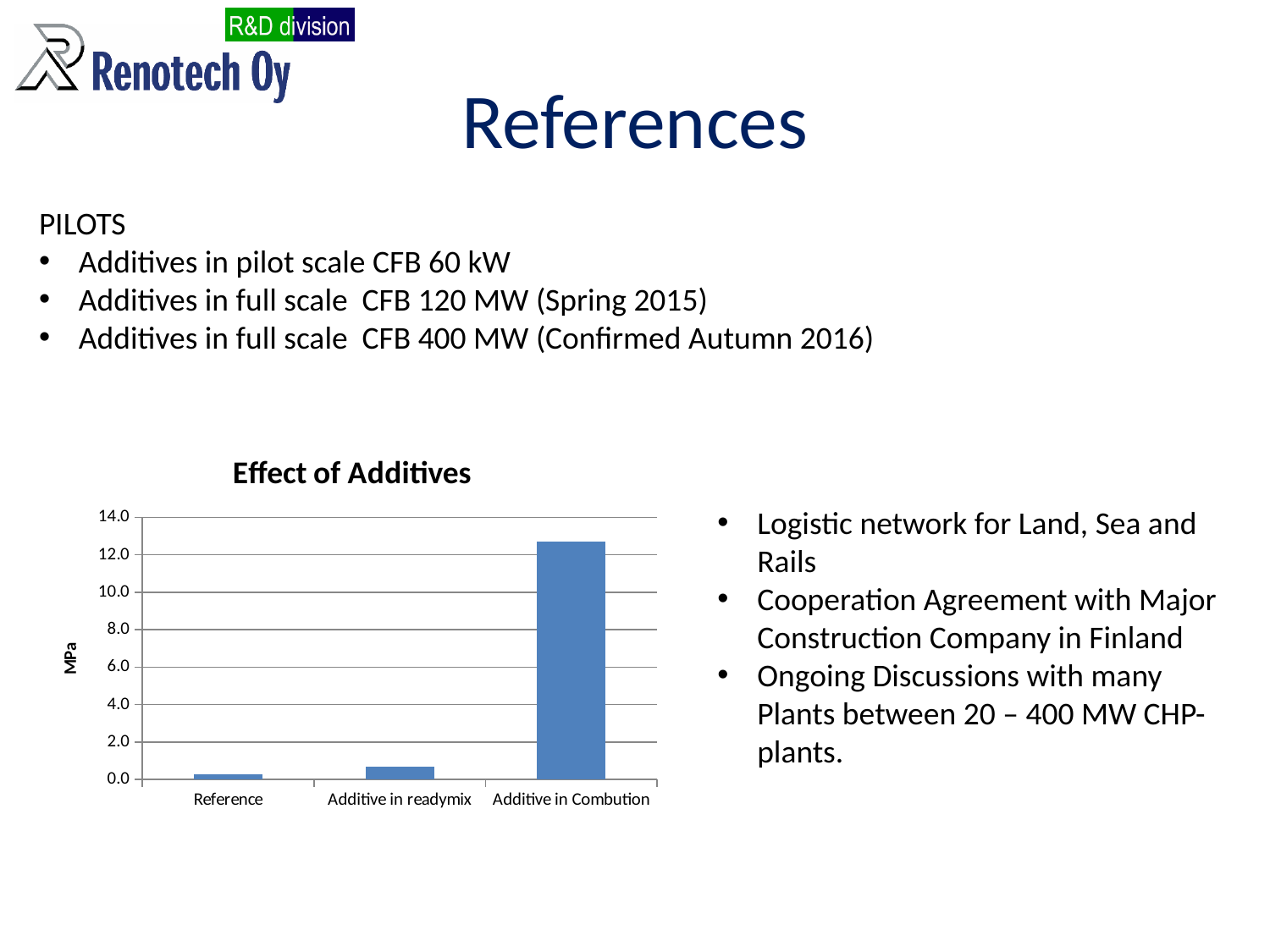
What is the title of the chart on the slide? Effect of Additives In the "Effect of Additives" chart, which is larger: the value for Additive in readymix or the value for Reference? Additive in readymix Is the value for Reference greater or less than 2.0 in the "Effect of Additives" chart? less How many categories are shown on the x axis of the "Effect of Additives" chart? 3 Do the values in the "Effect of Additives" chart rise or fall from left to right along the x axis? rise Is the value for Additive in Combution greater or less than 12.0 in the "Effect of Additives" chart? greater In the "Effect of Additives" chart, which is larger: the value for Reference or the value for Additive in Combution? Additive in Combution What kind of chart is shown under the title "Effect of Additives"? bar chart Which category has the highest value in the "Effect of Additives" chart? Additive in Combution Which category has the lowest value in the "Effect of Additives" chart? Reference What unit is shown on the y axis of the "Effect of Additives" chart? MPa Is the value for Additive in readymix greater or less than 2.0 in the "Effect of Additives" chart? less